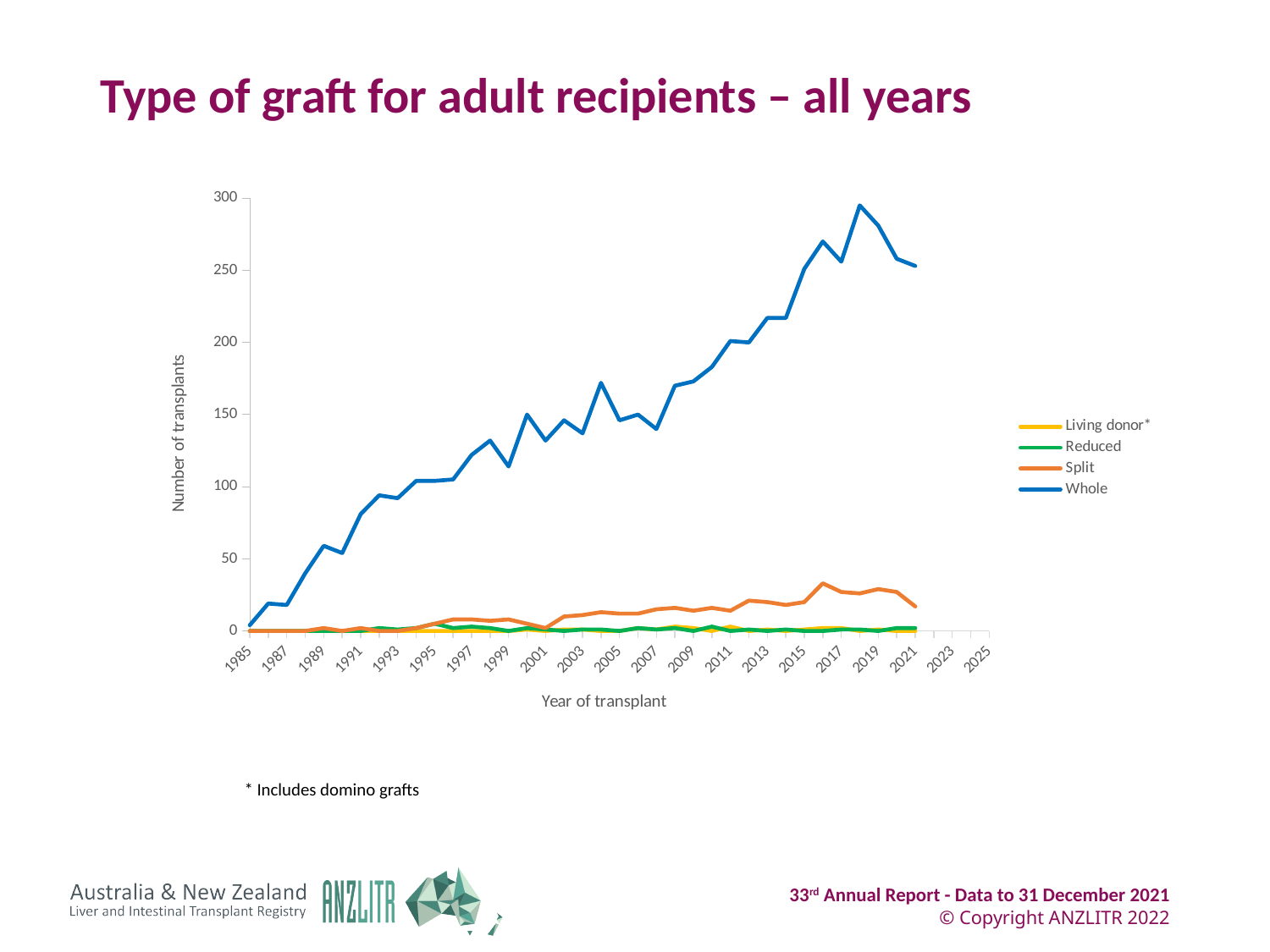
Is the value for Whole in 1985 greater or less than 50? less Does the Whole series generally rise or fall from 1985 to 2017? rise What kind of chart is shown on the slide? Line chart Is the value for Whole in 2017 greater or less than 250? greater In 2021, which series has the larger value, Whole or Split? Whole How many series does the legend list? 4 Is the value for Whole in 2005 greater or less than 100? greater What is the label of the y axis? Number of transplants Which series has the highest values across the chart? Whole What is the title of the chart? Type of graft for adult recipients – all years